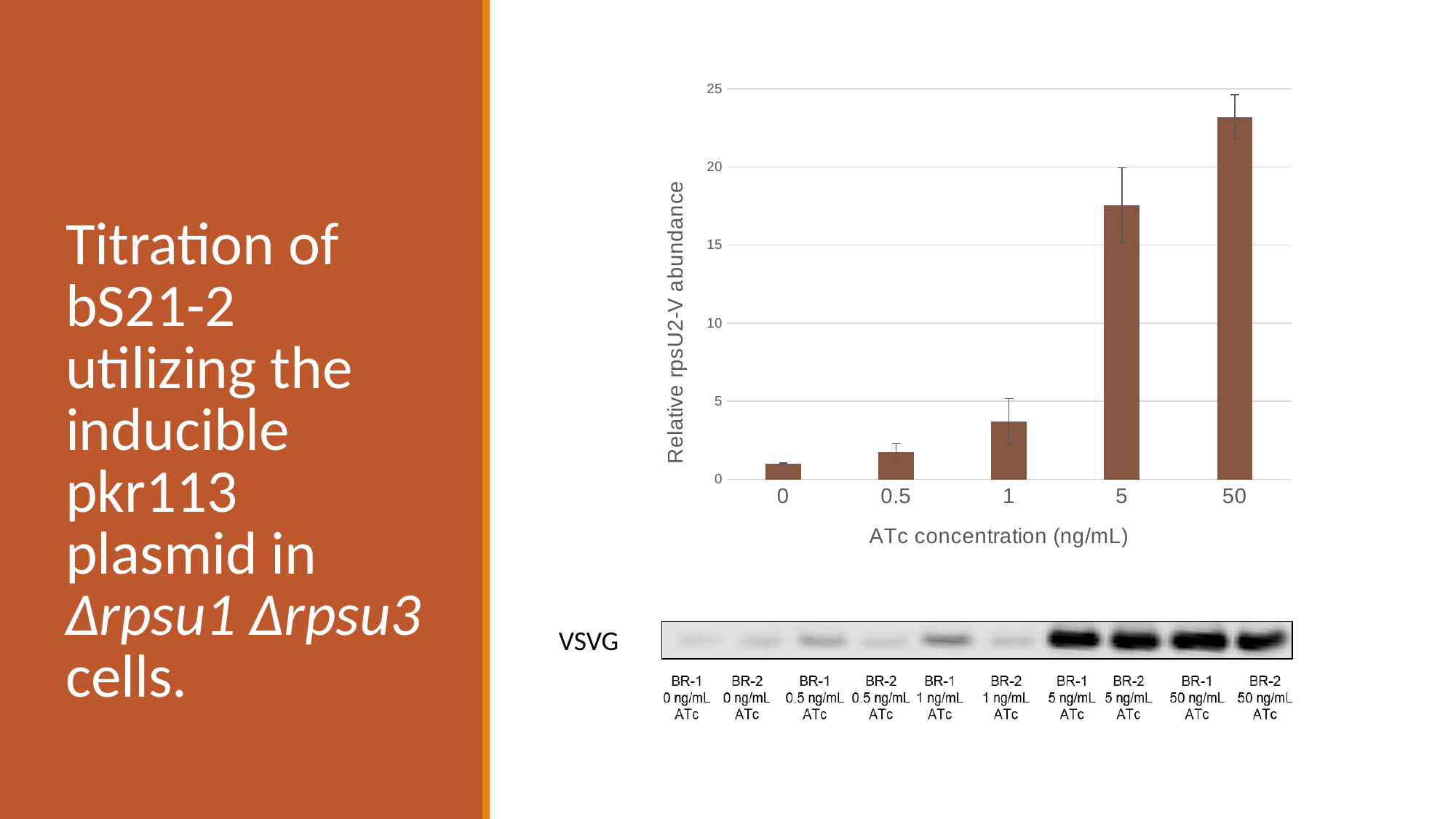
What is the title of the x axis of the bar chart? ATc concentration (ng/mL) Which has a larger relative rpsU2-V abundance, 5 ng/mL or 50 ng/mL ATc? 50 ng/mL Does the relative rpsU2-V abundance rise or fall as ATc concentration increases along the x axis? rise Is the relative rpsU2-V abundance at 5 ng/mL ATc greater or less than 20? less Is the relative rpsU2-V abundance at 50 ng/mL ATc greater or less than 20? greater What kind of chart is shown on the slide? bar chart Which ATc concentration has the highest relative rpsU2-V abundance? 50 Which has a larger relative rpsU2-V abundance, 0.5 ng/mL or 1 ng/mL ATc? 1 ng/mL Is the relative rpsU2-V abundance at 5 ng/mL ATc greater or less than 15? greater Which ATc concentration has the lowest relative rpsU2-V abundance? 0 How many ATc concentration categories are plotted in the bar chart? 5